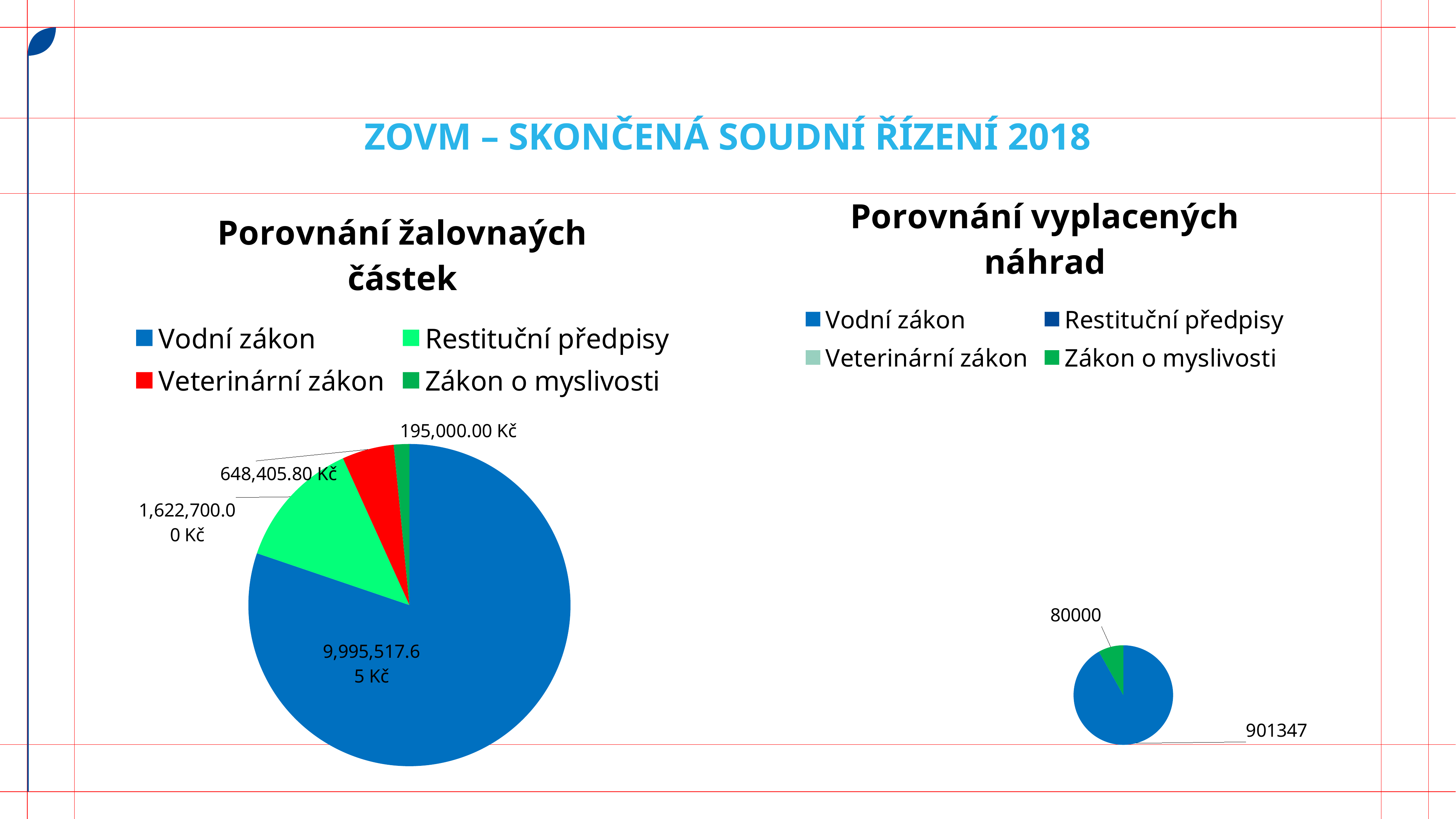
In the 'Porovnání vyplacených náhrad' chart, what is the value for Zákon o myslivosti? 80000 In the 'Porovnání žalovnaých částek' chart, what is the value for Zákon o myslivosti? 195,000.00 Kč In the 'Porovnání žalovnaých částek' chart, what is the difference between Restituční předpisy and Veterinární zákon? 974,294.20 Kč In the 'Porovnání žalovnaých částek' chart, which category has the largest slice? Vodní zákon In the 'Porovnání vyplacených náhrad' chart, what is the value for Vodní zákon? 901347 In the 'Porovnání žalovnaých částek' chart, what is the value for Vodní zákon? 9,995,517.65 Kč What kind of chart is the 'Porovnání žalovnaých částek' chart? pie chart In the 'Porovnání žalovnaých částek' chart, what is the value for Restituční předpisy? 1,622,700.00 Kč In the 'Porovnání žalovnaých částek' chart, which is larger: Restituční předpisy or Veterinární zákon? Restituční předpisy How many entries does the legend of the 'Porovnání žalovnaých částek' chart list? 4 In the 'Porovnání žalovnaých částek' chart, which category has the smallest slice? Zákon o myslivosti In the 'Porovnání žalovnaých částek' chart, what is the value for Veterinární zákon? 648,405.80 Kč